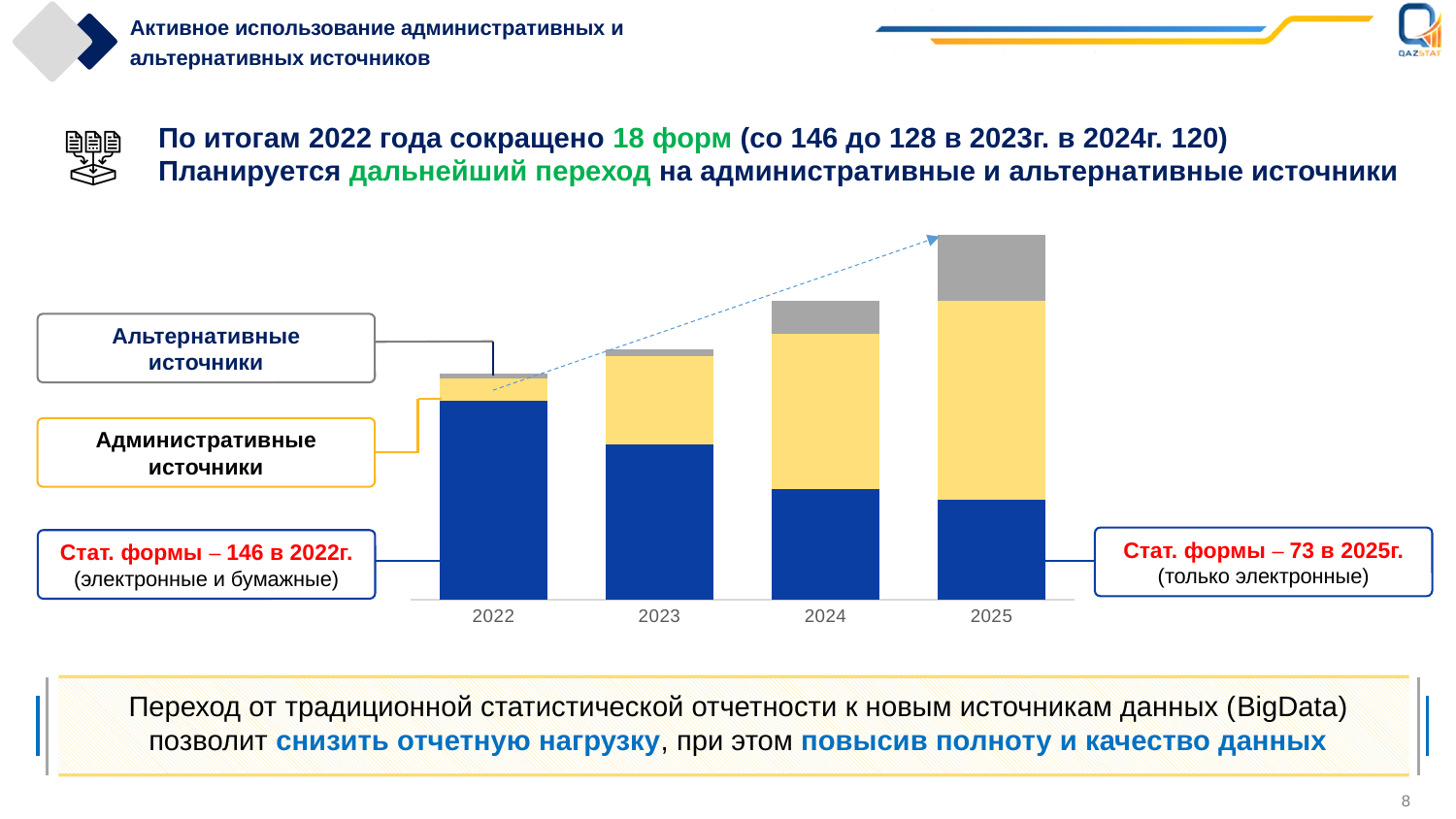
In which year is the grey segment (Альтернативные источники) the largest? 2025 What kind of chart is shown on the slide? stacked bar chart According to the callout on the chart, how many statistical forms (Стат. формы) are planned for 2025? 73 According to the callout on the chart, how many statistical forms (Стат. формы) were there in 2022? 146 In which year is the yellow segment (Административные источники) the smallest? 2022 Does the total height of the stacked bars rise or fall from 2022 to 2025? rise Which years are shown on the x axis of the chart? 2022, 2023, 2024, 2025 By how much does the number of statistical forms decrease from 2022 (146) to 2025 (73)? 73 Does the blue segment (Стат. формы) rise or fall from 2022 to 2025? fall How many years are shown on the x axis of the chart? 4 How many data series (source types) are stacked in each bar of the chart? 3 Which series is shown in blue on the chart? Стат. формы